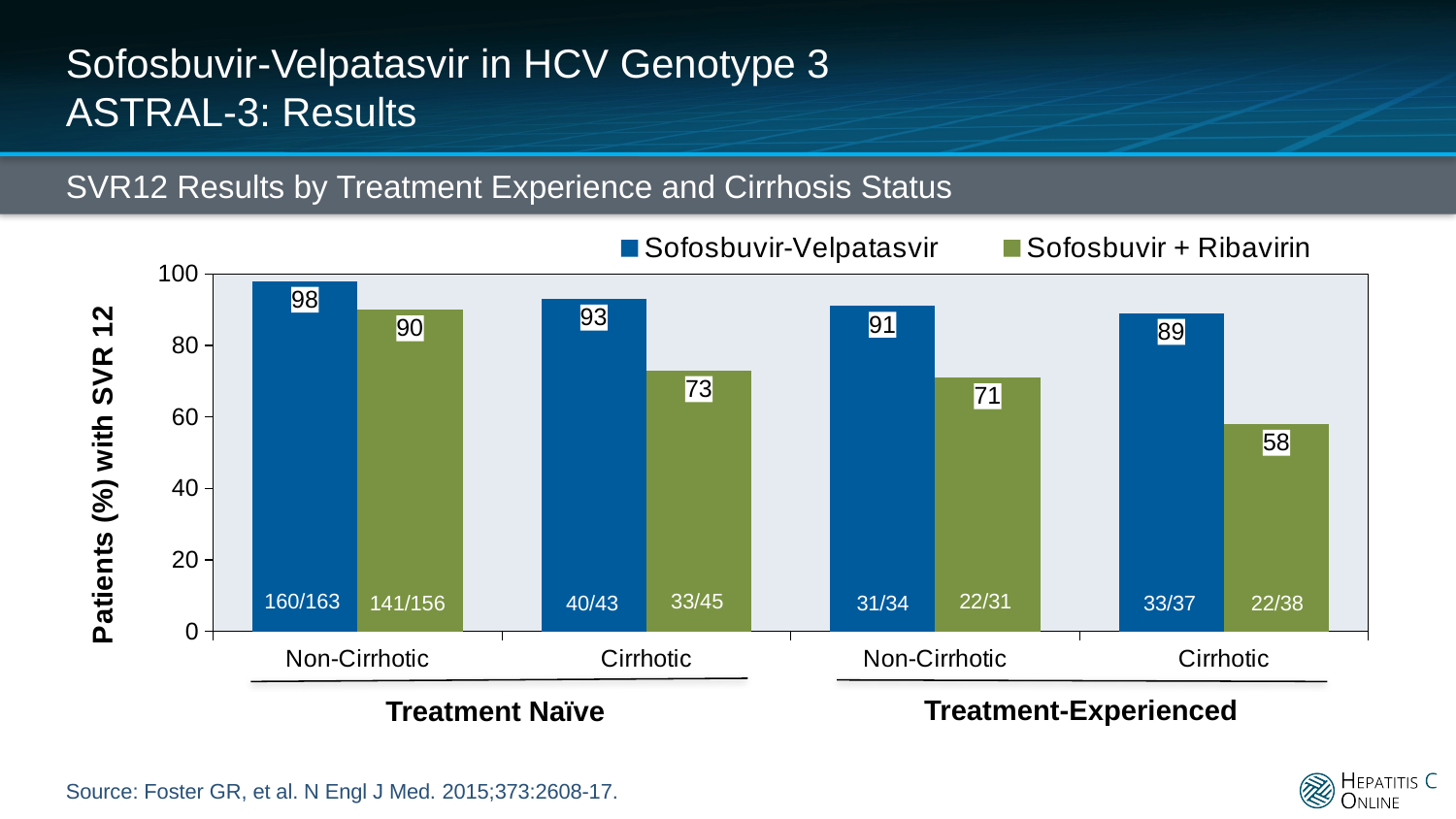
Which group has the highest SVR12 rate on the chart? Sofosbuvir-Velpatasvir, Treatment Naïve Non-Cirrhotic Which group has the lowest SVR12 rate on the chart? Sofosbuvir + Ribavirin, Treatment-Experienced Cirrhotic What fraction of patients is shown for Sofosbuvir-Velpatasvir in Treatment-Experienced Non-Cirrhotic patients? 31/34 What kind of chart is shown on the slide? Bar chart What is the SVR12 rate for Sofosbuvir + Ribavirin in Treatment Naïve Cirrhotic patients? 73 How many series does the legend list? 2 What is the difference in SVR12 rate between Sofosbuvir-Velpatasvir and Sofosbuvir + Ribavirin in Treatment Naïve Cirrhotic patients? 20 What is the SVR12 rate for Sofosbuvir + Ribavirin in Treatment-Experienced Cirrhotic patients? 58 What is the label of the y axis? Patients (%) with SVR 12 What is the difference in SVR12 rate between Sofosbuvir-Velpatasvir and Sofosbuvir + Ribavirin in Treatment-Experienced Cirrhotic patients? 31 What is the SVR12 rate for Sofosbuvir-Velpatasvir in Treatment Naïve Non-Cirrhotic patients? 98 Which is larger: the SVR12 rate for Sofosbuvir-Velpatasvir in Treatment-Experienced Non-Cirrhotic patients or for Sofosbuvir + Ribavirin in Treatment Naïve Non-Cirrhotic patients? Sofosbuvir-Velpatasvir in Treatment-Experienced Non-Cirrhotic (91)